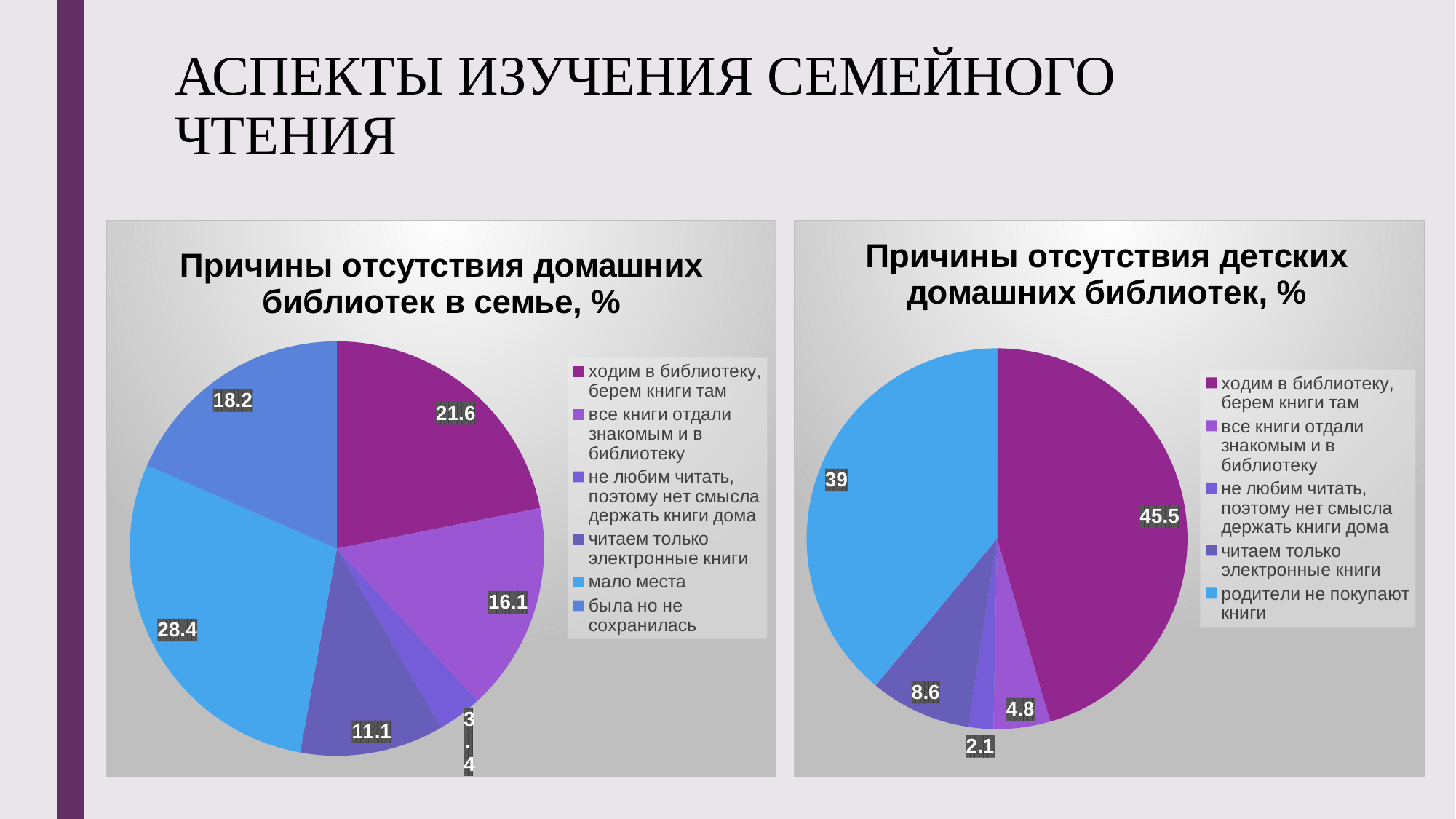
In the left chart 'Причины отсутствия домашних библиотек в семье, %', which category has the smallest slice? не любим читать, поэтому нет смысла держать книги дома How many categories does the legend of the left chart 'Причины отсутствия домашних библиотек в семье, %' list? 6 In the left chart 'Причины отсутствия домашних библиотек в семье, %', what is the difference between 'мало места' and 'была но не сохранилась'? 10.2 In the left chart 'Причины отсутствия домашних библиотек в семье, %', which category has the largest slice? мало места In the right chart 'Причины отсутствия детских домашних библиотек, %', which is larger: 'все книги отдали знакомым и в библиотеку' or 'не любим читать, поэтому нет смысла держать книги дома'? все книги отдали знакомым и в библиотеку In the right chart 'Причины отсутствия детских домашних библиотек, %', which category has the largest slice? ходим в библиотеку, берем книги там In the right chart 'Причины отсутствия детских домашних библиотек, %', what is the value for 'родители не покупают книги'? 39 What kind of chart is the left chart, 'Причины отсутствия домашних библиотек в семье, %'? Pie chart In the right chart 'Причины отсутствия детских домашних библиотек, %', what is the value for 'читаем только электронные книги'? 8.6 In the left chart 'Причины отсутствия домашних библиотек в семье, %', what is the value for 'мало места'? 28.4 In the left chart 'Причины отсутствия домашних библиотек в семье, %', what is the value for 'ходим в библиотеку, берем книги там'? 21.6 How many categories does the legend of the right chart 'Причины отсутствия детских домашних библиотек, %' list? 5